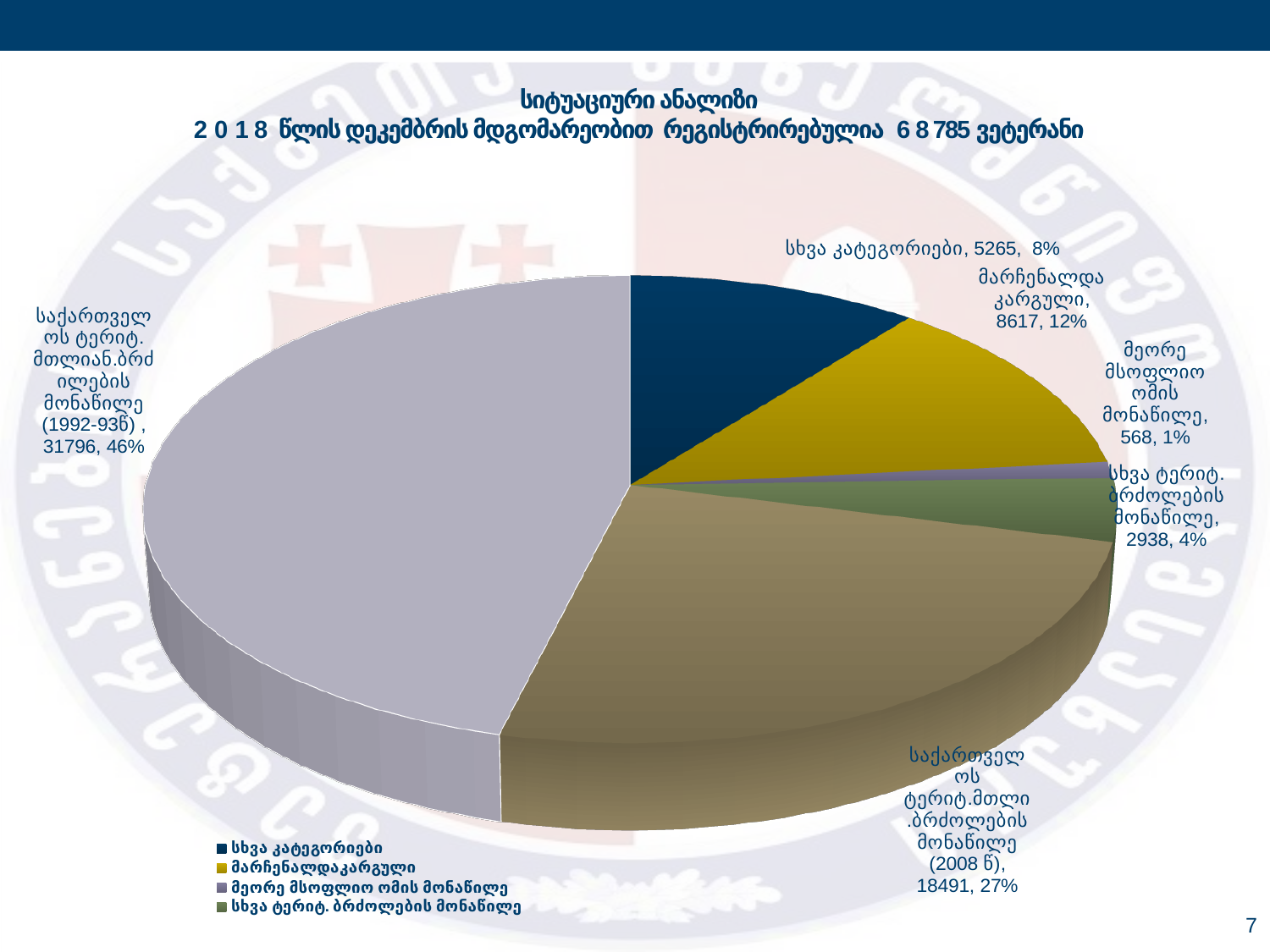
Which is larger: the value for "მარჩენალდაკარგული" or the value for "სხვა კატეგორიები"? მარჩენალდაკარგული How many entries does the legend list? 4 Which slice of the pie chart is the smallest? მეორე მსოფლიო ომის მონაწილე What is the difference between the value for the 1992-93 slice (31796) and the 2008 slice (18491)? 13305 What percentage share is shown for the slice "მარჩენალდაკარგული"? 12% What percentage share is shown for the slice labelled with the year 2008 (2008 წ)? 27% How many slices does the pie chart have? 6 What value is shown for the slice "მეორე მსოფლიო ომის მონაწილე"? 568 What kind of chart is shown on the slide? pie chart What percentage share is shown for the slice "სხვა ტერიტ. ბრძოლების მონაწილე"? 4% Which slice of the pie chart is the largest? საქართველოს ტერიტ. მთლიან.ბრძოლების მონაწილე (1992-93წ) What value is shown for the slice labelled "სხვა კატეგორიები"? 5265